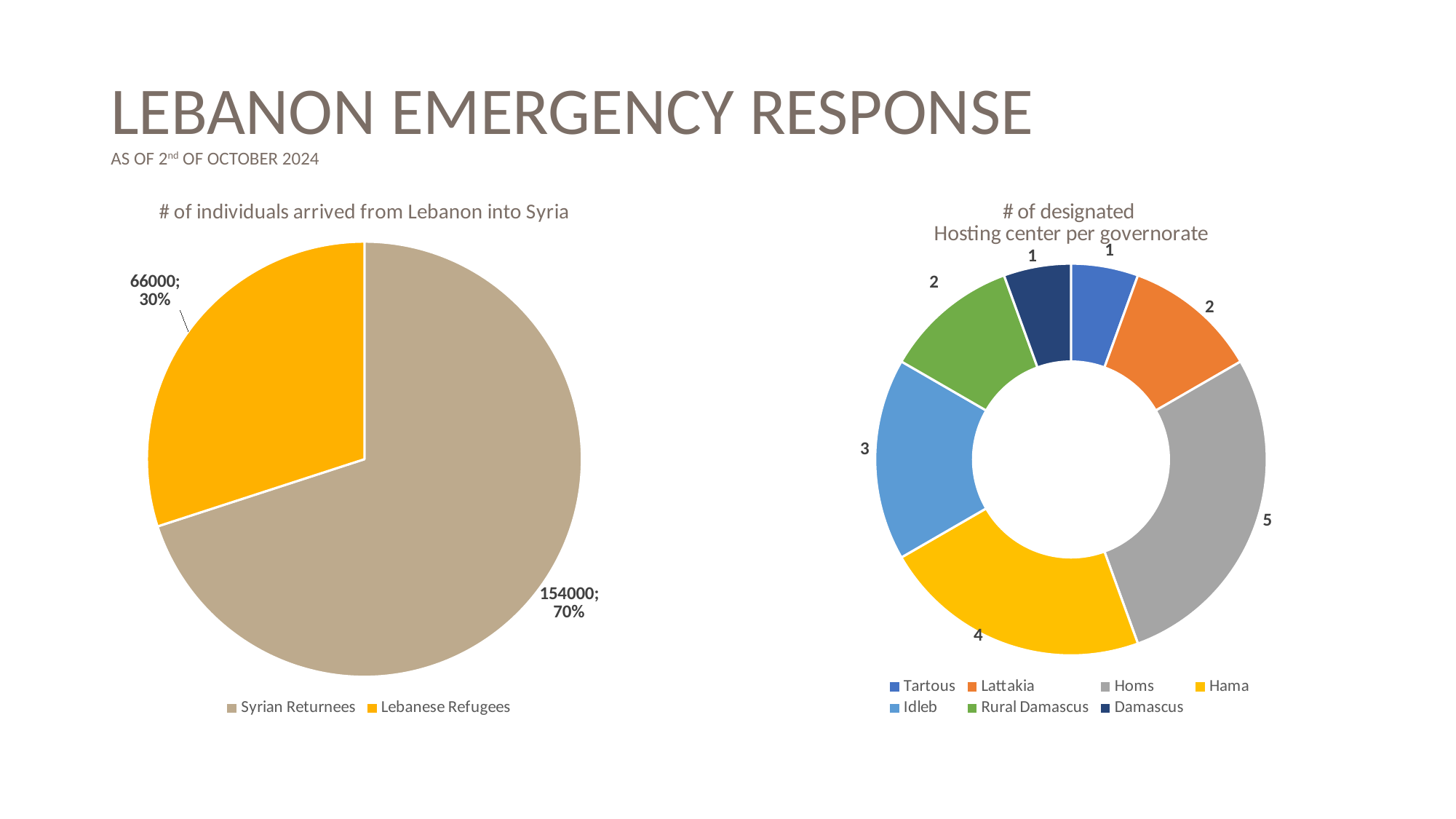
In the chart '# of individuals arrived from Lebanon into Syria', what type of chart is used? Pie chart In the chart '# of designated Hosting center per governorate', how many hosting centers does Homs have? 5 In the chart '# of individuals arrived from Lebanon into Syria', what share of the pie do Lebanese Refugees represent? 30% In the chart '# of designated Hosting center per governorate', how many governorates are listed in the legend? 7 In the chart '# of designated Hosting center per governorate', how many hosting centers does Idleb have? 3 In the chart '# of individuals arrived from Lebanon into Syria', what is the difference between Syrian Returnees and Lebanese Refugees? 88000 In the chart '# of individuals arrived from Lebanon into Syria', how many Syrian Returnees are shown? 154000 In the chart '# of designated Hosting center per governorate', which governorate has the most hosting centers? Homs In the chart '# of designated Hosting center per governorate', which has more hosting centers, Hama or Lattakia? Hama In the chart '# of individuals arrived from Lebanon into Syria', how many Lebanese Refugees are shown? 66000 In the chart '# of designated Hosting center per governorate', what is the difference between the hosting centers in Homs and in Tartous? 4 In the chart '# of individuals arrived from Lebanon into Syria', how many categories does the legend list? 2